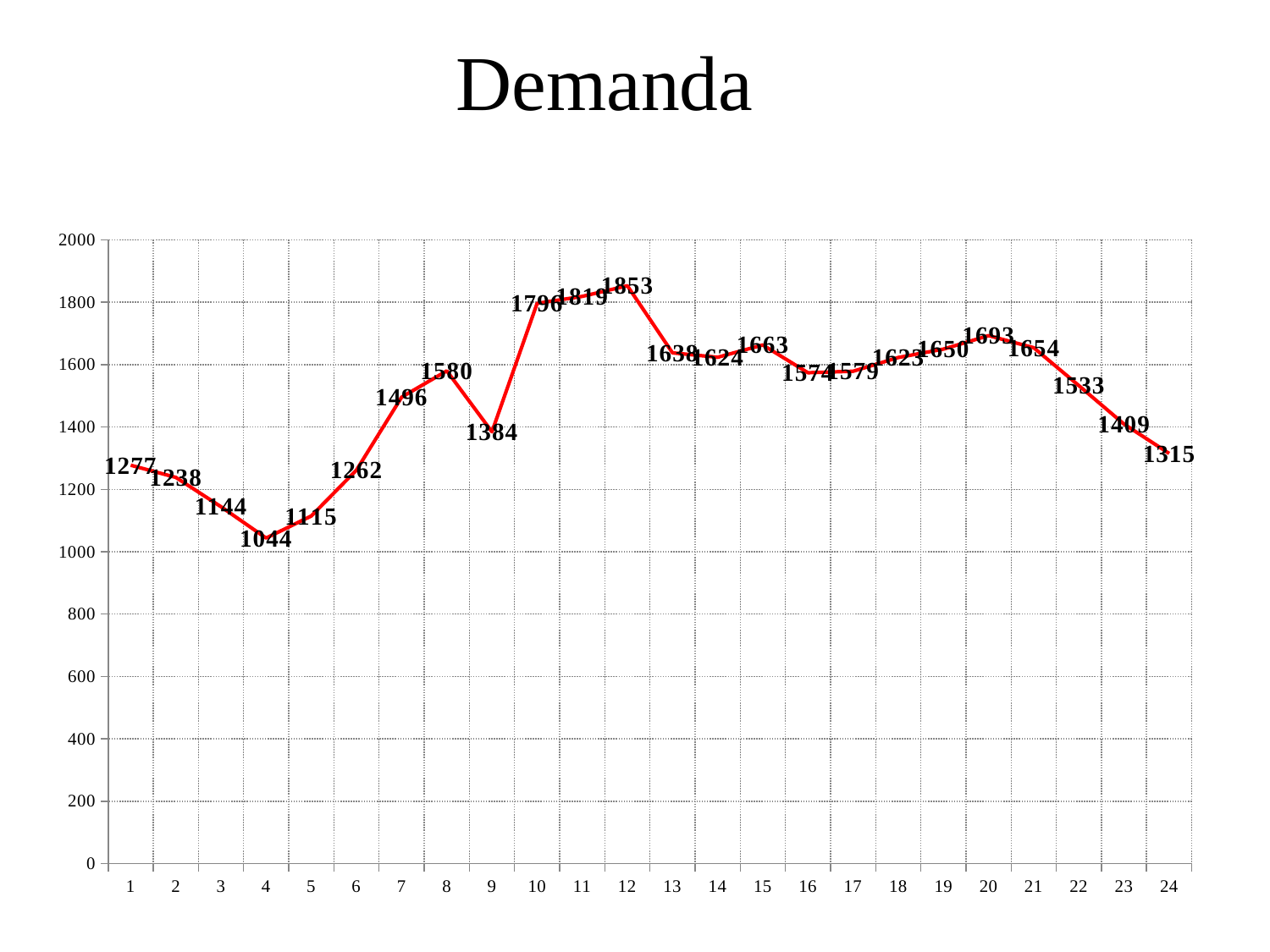
At which x-axis point is the value highest? 12 What is the value at point 4? 1044 What is the title of the chart? Demanda Do the values rise or fall from point 20 to point 24? fall Which is larger, the value at point 8 or the value at point 9? point 8 What kind of chart is shown on the slide? line chart At which x-axis point is the value lowest? 4 What is the value at point 24? 1315 What is the value at point 12? 1853 How many points are plotted along the x axis? 24 What is the difference between the values at point 12 and point 4? 809 What is the value at point 9? 1384